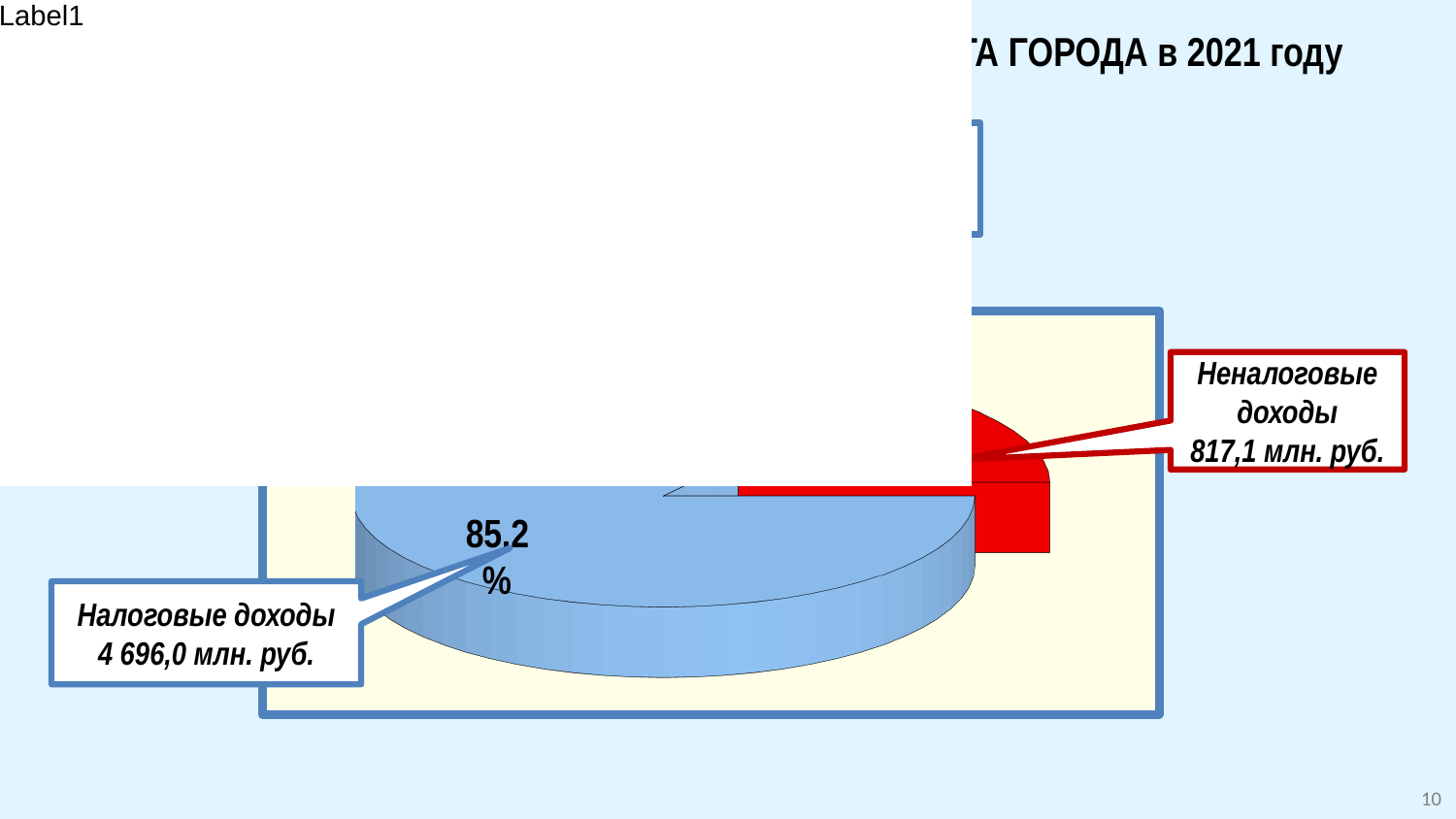
What is the difference between Налоговые доходы (4 696,0 млн. руб.) and Неналоговые доходы (817,1 млн. руб.)? 3 878,9 млн. руб. What colour is the Налоговые доходы slice? blue What kind of chart is shown on the slide? pie chart What share of the pie does the Налоговые доходы slice represent? 85.2% What value is given for Неналоговые доходы in the callout? 817,1 млн. руб. Which of the labelled slices is the largest? Налоговые доходы Which is larger, Налоговые доходы or Неналоговые доходы? Налоговые доходы Is the share of Налоговые доходы greater or less than 50%? greater What value is given for Налоговые доходы in the callout? 4 696,0 млн. руб. What colour is the Неналоговые доходы slice? red